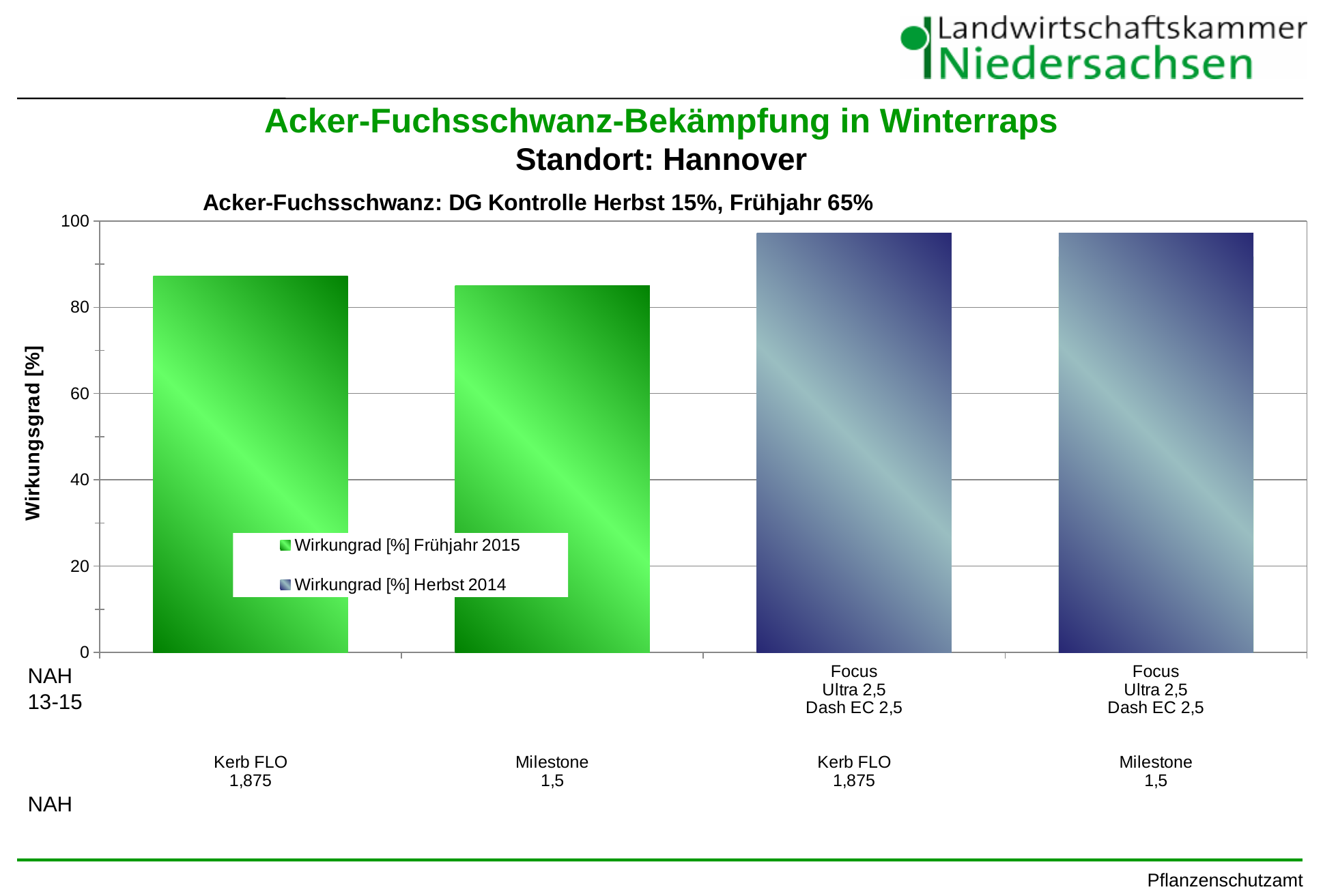
What is the title of the chart? Acker-Fuchsschwanz: DG Kontrolle Herbst 15%, Frühjahr 65% How many bars are plotted in the chart? 4 What kind of chart is shown on the slide? bar chart What is the label of the y axis? Wirkungsgrad [%] Is the value for Milestone 1,5 (Frühjahr 2015) greater or less than 90? less Which is larger: the value for Milestone 1,5 (Frühjahr 2015) or the value for Focus Ultra 2,5 + Dash EC 2,5 / Milestone 1,5 (Herbst 2014)? Focus Ultra 2,5 + Dash EC 2,5 / Milestone 1,5 (Herbst 2014) How many series does the chart legend list? 2 Is the value for Focus Ultra 2,5 + Dash EC 2,5 / Milestone 1,5 (Herbst 2014) greater or less than 90? greater Is the value for Milestone 1,5 (Frühjahr 2015) greater or less than 80? greater Which is larger: the value for Kerb FLO 1,875 (Frühjahr 2015) or the value for Focus Ultra 2,5 + Dash EC 2,5 / Kerb FLO 1,875 (Herbst 2014)? Focus Ultra 2,5 + Dash EC 2,5 / Kerb FLO 1,875 (Herbst 2014)